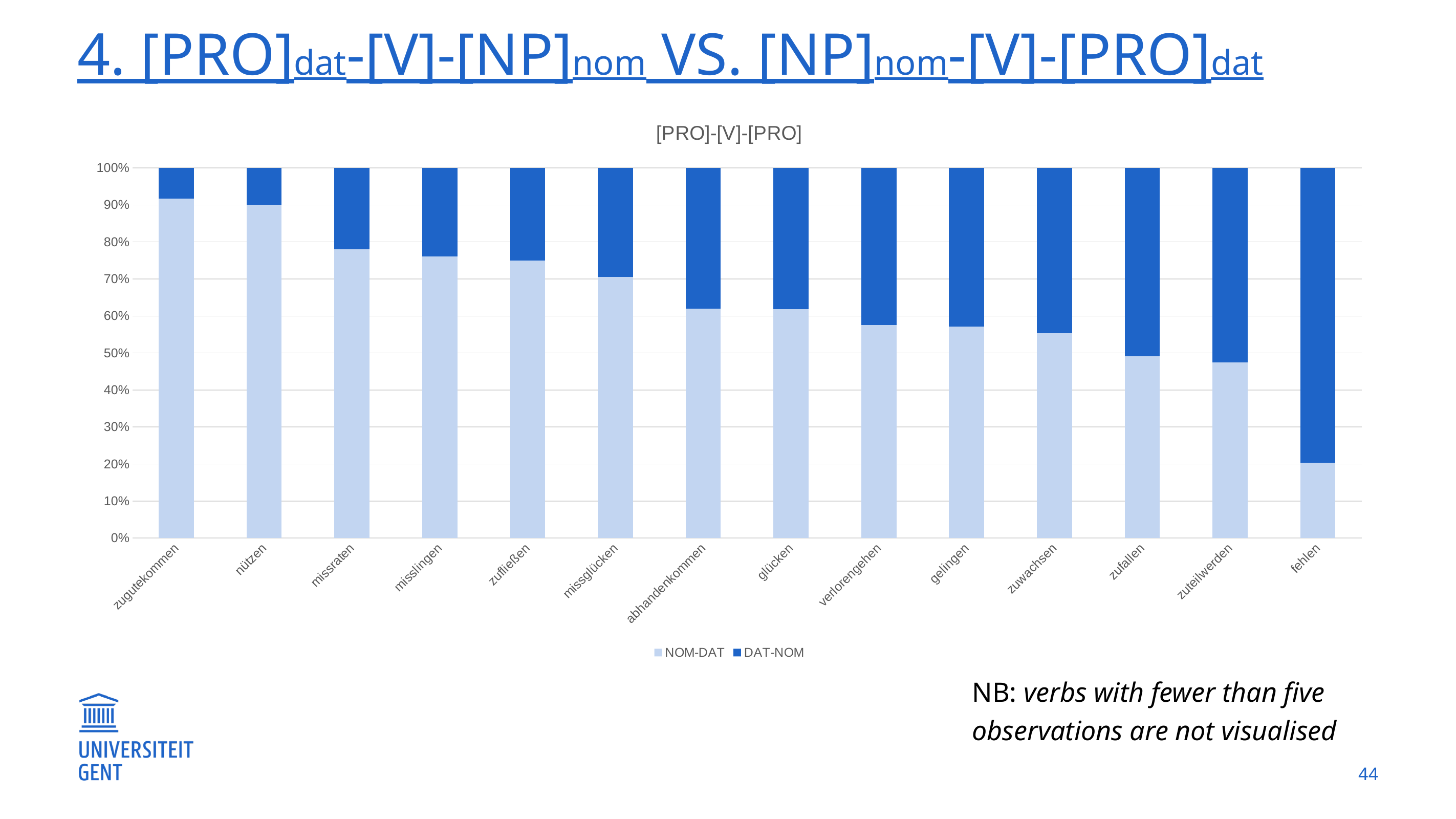
Is the NOM-DAT share for zuteilwerden greater or less than 50%? less How many verbs (categories) are plotted along the x axis? 14 Which verb has a larger NOM-DAT share, missraten or gelingen? missraten Which verb has the lowest NOM-DAT share? fehlen Is the NOM-DAT share for fehlen greater or less than 30%? less Does the NOM-DAT share rise or fall moving from left to right along the x axis? fall What kind of chart is shown on the slide? Stacked bar chart What is the title of the chart? [PRO]-[V]-[PRO] Is the NOM-DAT share for missraten greater or less than 70%? greater How many series does the legend list? 2 Which two series are listed in the legend? NOM-DAT and DAT-NOM Which verb has the highest DAT-NOM share? fehlen